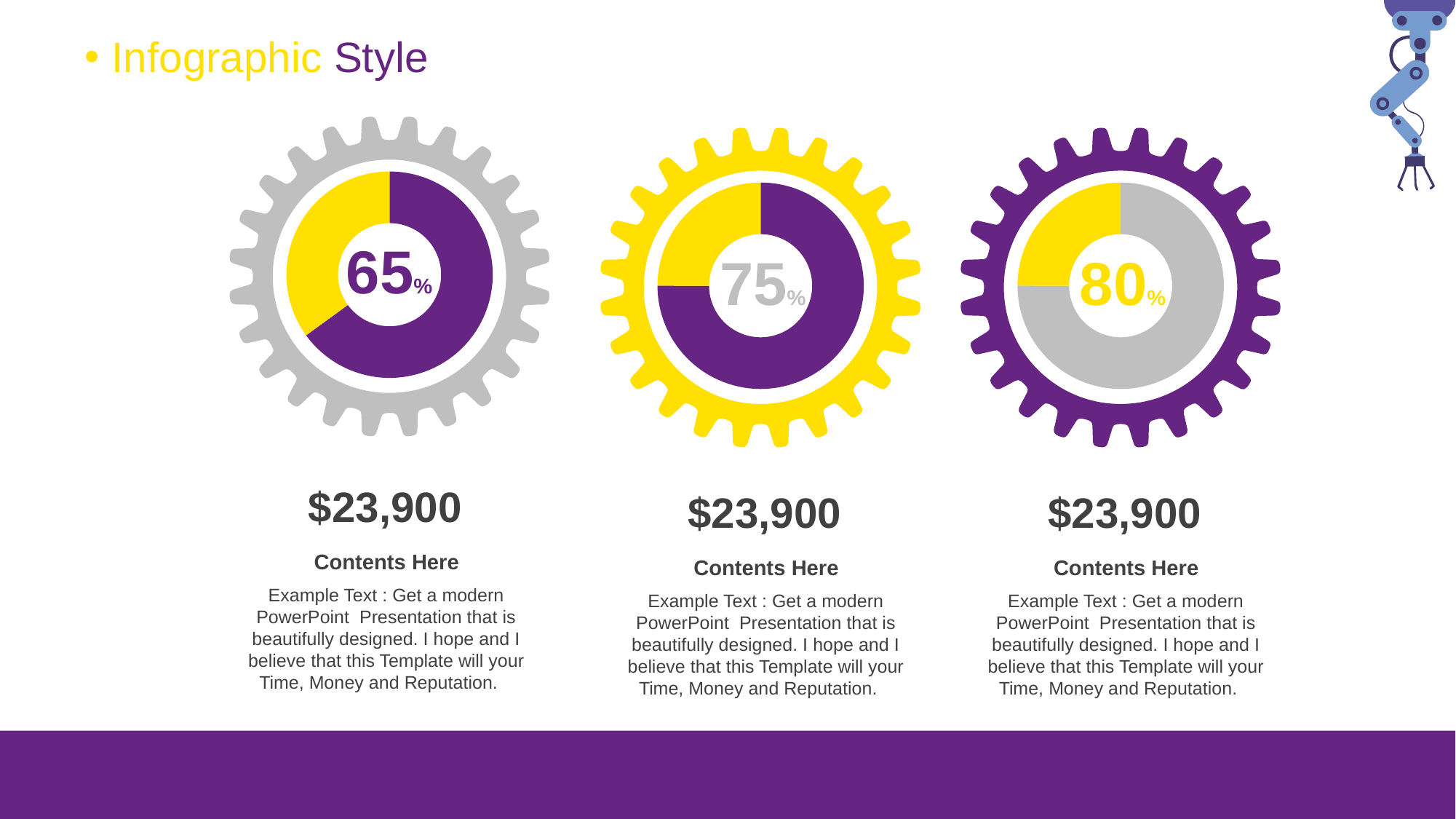
What is the difference between the percentage in the right gear chart and the percentage in the left gear chart? 15% What is the difference between the percentage in the middle gear chart and the percentage in the left gear chart? 10% What percentage is shown in the centre of the right gear chart? 80% Which of the three gear charts shows the highest percentage? The right chart (80%) What kind of chart is shown inside each gear? Donut chart What dollar value is printed below the middle gear chart? $23,900 What percentage is shown in the centre of the left gear chart? 65% How many gear-shaped donut charts are on the slide? 3 Which of the three gear charts shows the lowest percentage? The left chart (65%) What percentage is shown in the centre of the middle gear chart? 75% What colour is the gear surrounding the middle chart? Yellow Which is larger, the percentage in the middle gear chart or the percentage in the right gear chart? The right chart (80%)